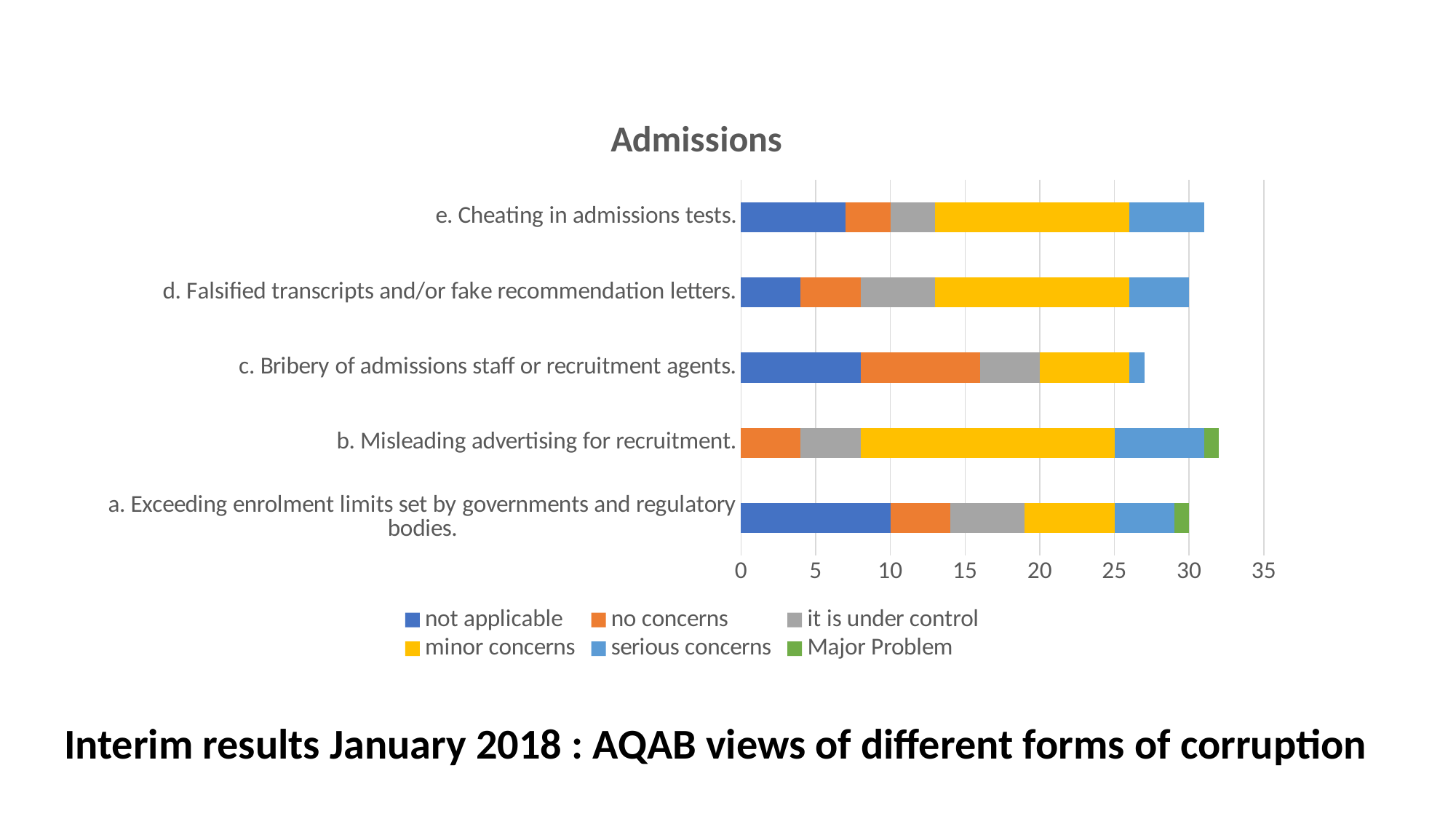
Which series is shown in green? Major Problem How many categories are plotted on the chart? 5 What type of chart is shown on the slide? bar chart Which is larger: the 'not applicable' value for 'a. Exceeding enrolment limits set by governments and regulatory bodies.' or for 'e. Cheating in admissions tests.'? a. Exceeding enrolment limits set by governments and regulatory bodies. Is the total bar length for 'b. Misleading advertising for recruitment.' greater or less than 30? greater Is the 'not applicable' value for 'a. Exceeding enrolment limits set by governments and regulatory bodies.' greater or less than 5? greater Which is larger: the 'minor concerns' value for 'b. Misleading advertising for recruitment.' or for 'c. Bribery of admissions staff or recruitment agents.'? b. Misleading advertising for recruitment. How many series does the legend list? 6 What is the title of the chart? Admissions Which category has the largest 'no concerns' segment? c. Bribery of admissions staff or recruitment agents. Which category has the shortest total bar? c. Bribery of admissions staff or recruitment agents. Is the total bar length for 'c. Bribery of admissions staff or recruitment agents.' greater or less than 30? less